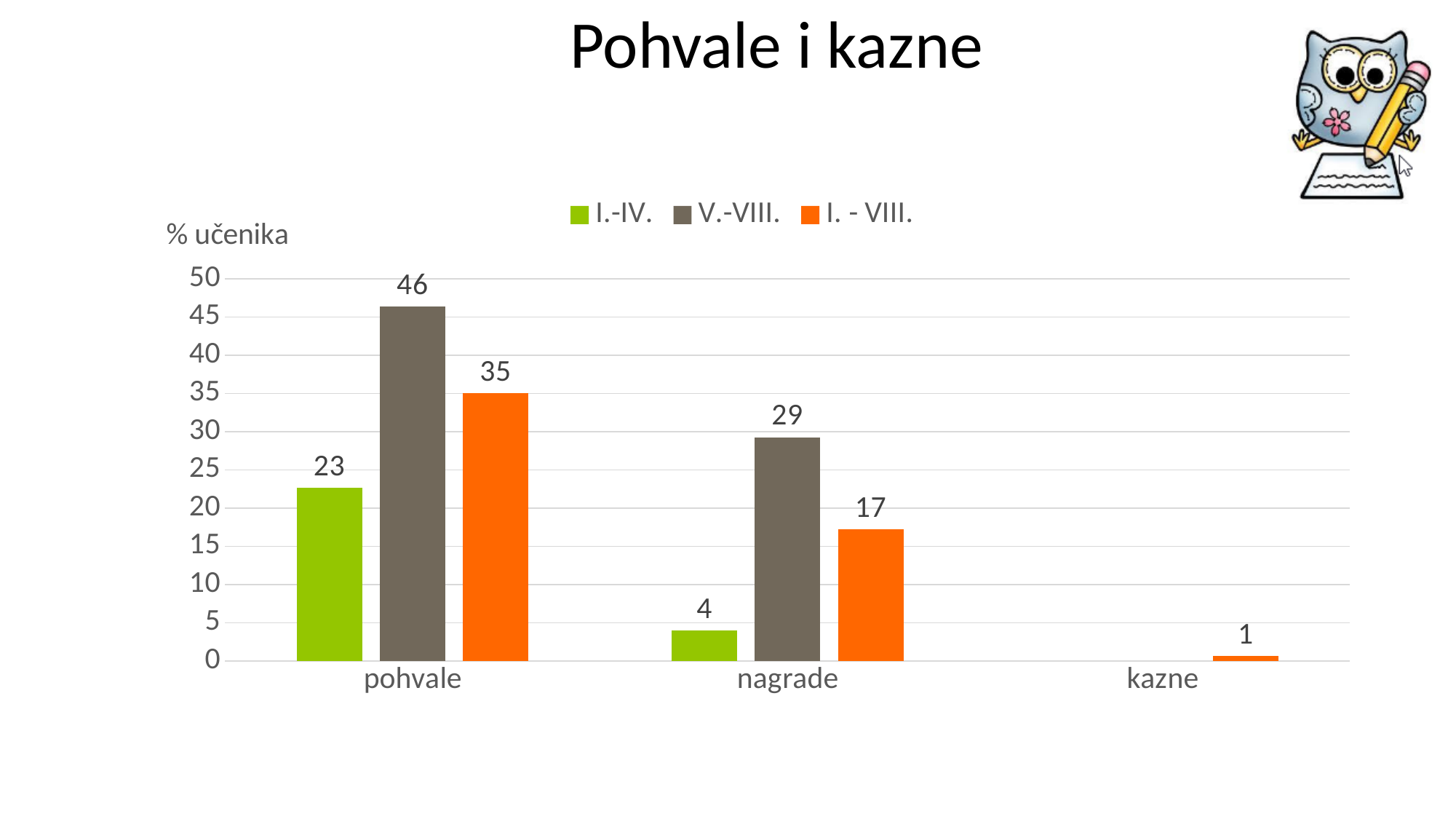
How many series does the legend list? 3 What is the value for I. - VIII. in the pohvale category? 35 Which category has the lowest value for the I. - VIII. series? kazne How many categories are shown on the x axis? 3 What is the difference between the V.-VIII. and I.-IV. values in the pohvale category? 23 What is the value for I. - VIII. in the kazne category? 1 Which category has the highest value for the V.-VIII. series? pohvale What kind of chart is shown on the slide? bar chart What is the label on the vertical axis of the chart? % učenika Which is larger in the nagrade category: the V.-VIII. value or the I. - VIII. value? V.-VIII. What is the value for I.-IV. in the nagrade category? 4 What is the value for V.-VIII. in the pohvale category? 46